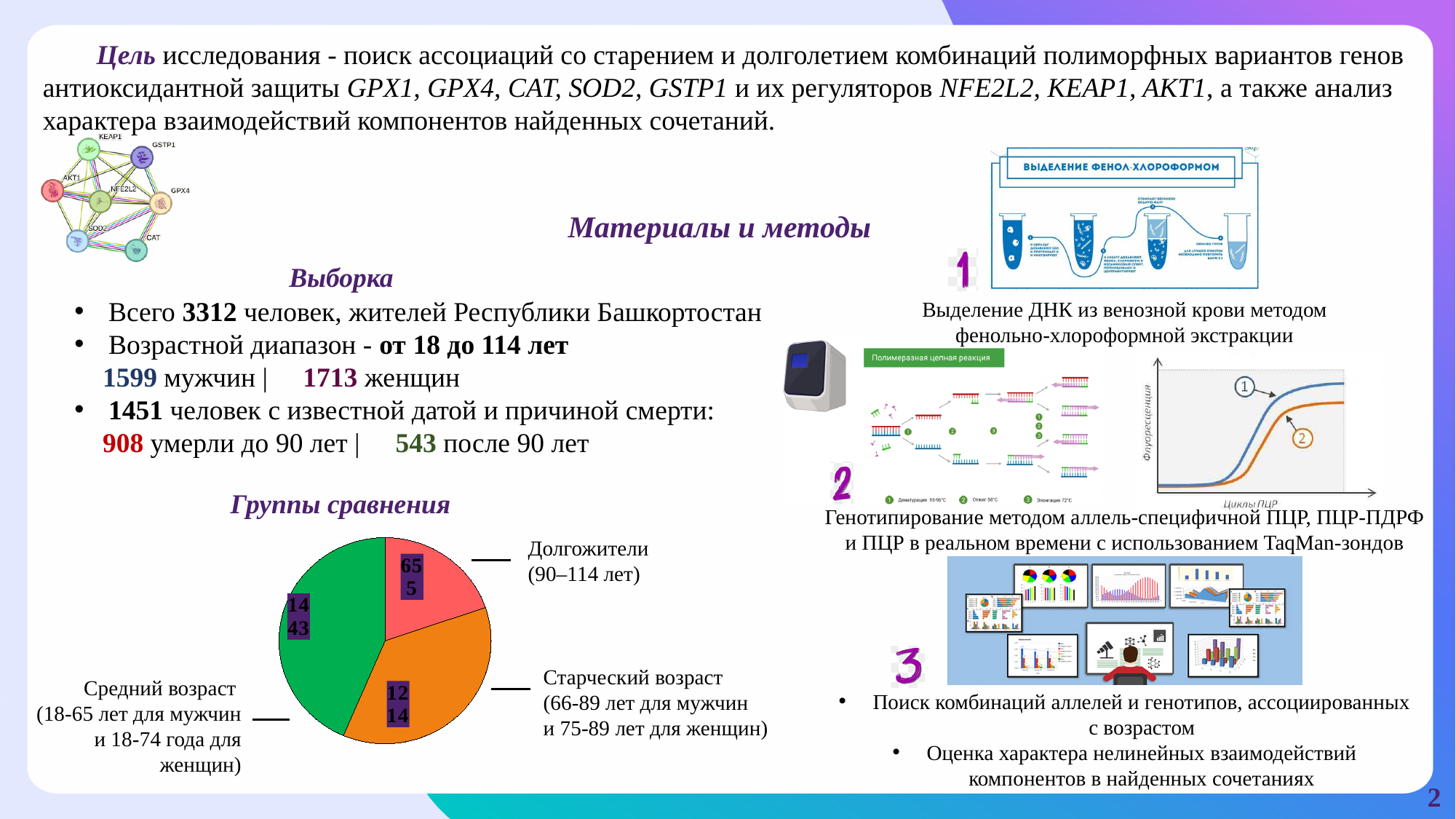
What kind of chart is shown under the heading «Группы сравнения»? pie chart In the «Группы сравнения» pie chart, what is the difference between the Средний возраст and Старческий возраст values? 229 How many slices does the «Группы сравнения» pie chart have? 3 In the «Группы сравнения» pie chart, what is the value for Долгожители (90–114 лет)? 655 In the «Группы сравнения» pie chart, which is larger: Старческий возраст or Долгожители? Старческий возраст What share of the «Группы сравнения» pie does the Средний возраст slice represent? 43.6% In the «Группы сравнения» pie chart, what is the value for Средний возраст? 1443 What is the total of all three slices in the «Группы сравнения» pie chart? 3312 Which group has the largest slice in the «Группы сравнения» pie chart? Средний возраст In the «Группы сравнения» pie chart, what is the value for Старческий возраст? 1214 Which group has the smallest slice in the «Группы сравнения» pie chart? Долгожители (90–114 лет) What colour is the Долгожители slice in the «Группы сравнения» pie chart? red